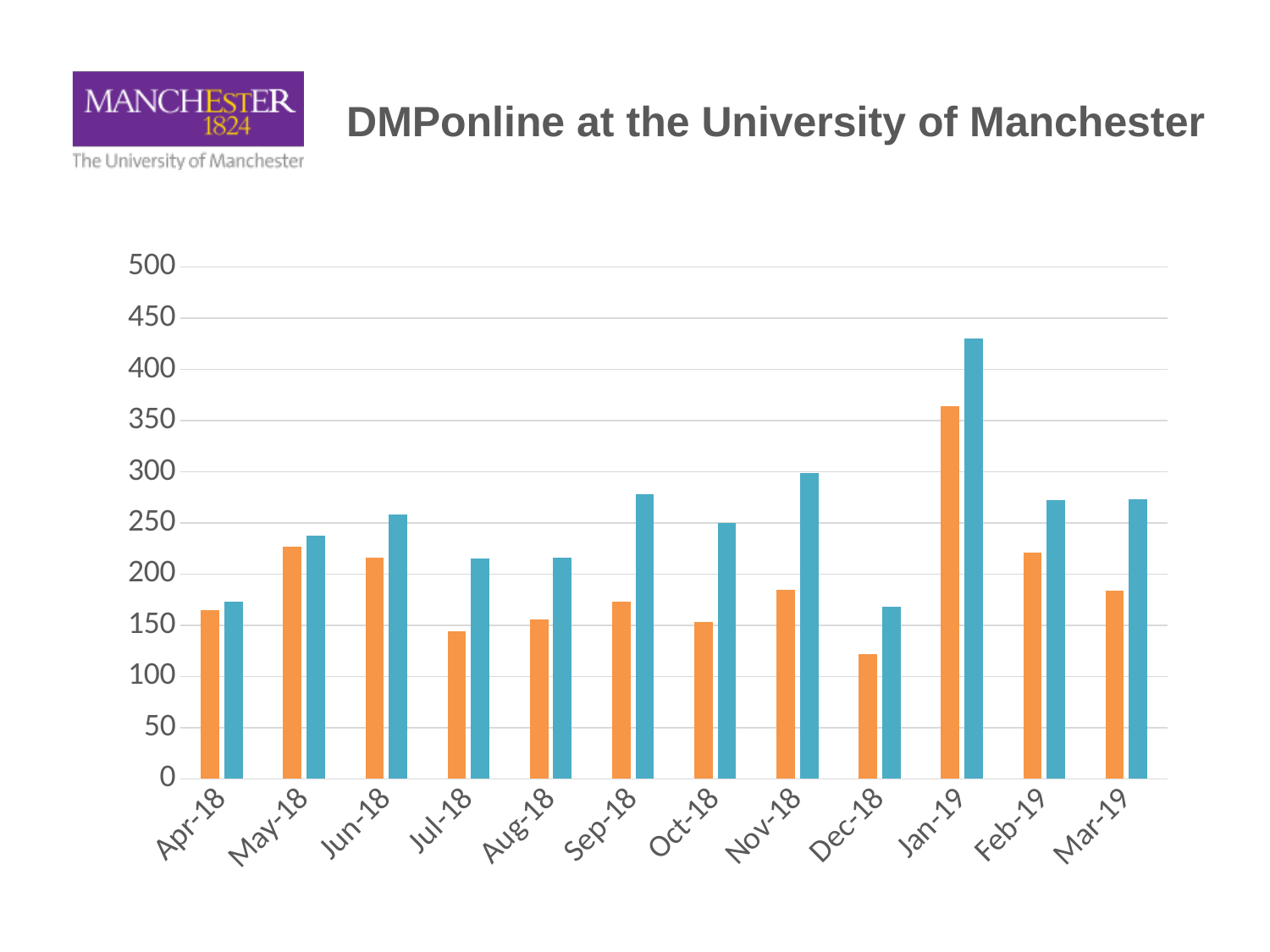
What is the title shown at the top of the slide? DMPonline at the University of Manchester Is the value of the blue bar for Jan-19 greater or less than 400? greater Is the value of the blue bar for Sep-18 greater or less than 250? greater Is the value of the orange bar for Dec-18 greater or less than 150? less In which month is the blue bar highest? Jan-19 In which month is the orange bar lowest? Dec-18 In Jan-19, which bar is taller, the orange bar or the blue bar? the blue bar How many bars are plotted for each month in the chart? 2 How many months are shown on the x axis of the chart? 12 In which month is the orange bar highest? Jan-19 What kind of chart is shown on the slide? bar chart